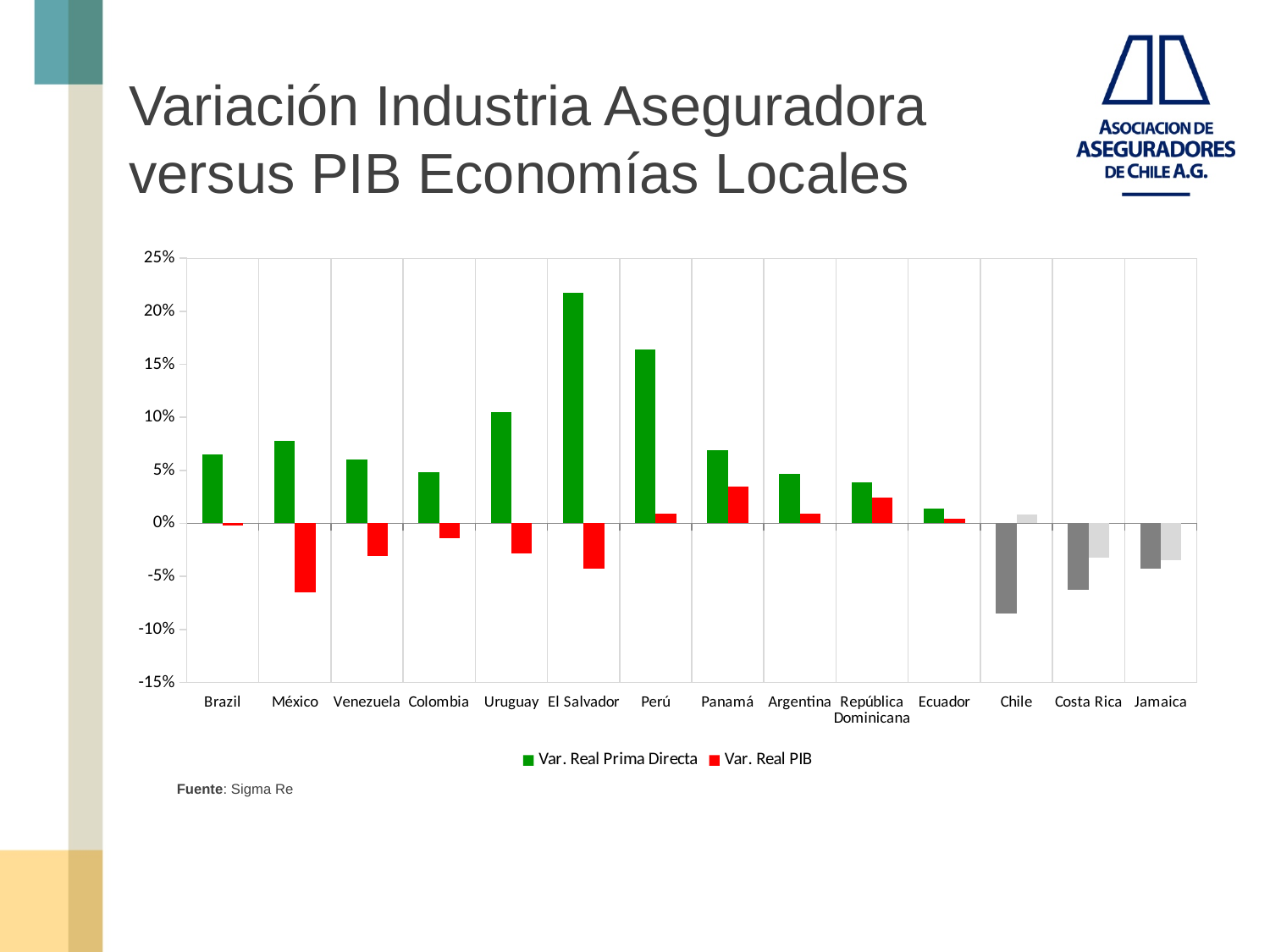
Is the Var. Real Prima Directa for Perú greater or less than 15%? greater What is the title of the chart on the slide? Variación Industria Aseguradora versus PIB Economías Locales Which country has the highest Var. Real PIB? Panamá Is the Var. Real Prima Directa for El Salvador greater or less than 20%? greater Which country has the lowest Var. Real Prima Directa? Chile Which country has the lowest Var. Real PIB? México How many series does the legend list? 2 Is the Var. Real Prima Directa for Chile greater or less than -5%? less Which has the larger Var. Real Prima Directa, Perú or Panamá? Perú How many countries are shown on the x axis? 14 Which country has the highest Var. Real Prima Directa? El Salvador What kind of chart is shown on the slide? bar chart